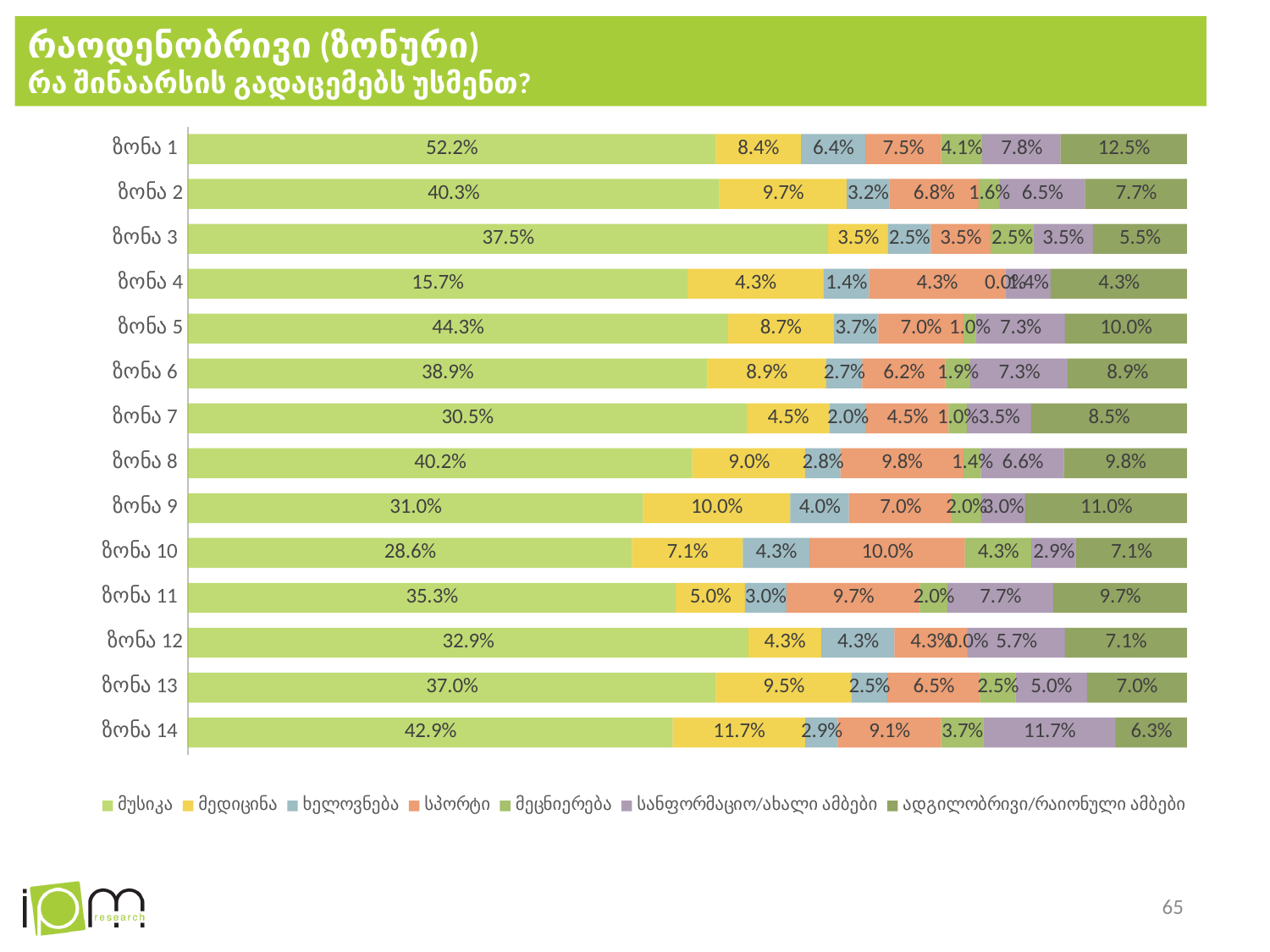
What type of chart is shown on the slide? stacked bar chart Which series is shown first (leftmost) in the legend? მუსიკა Which zone has the highest value for მუსიკა? ზონა 1 What is the value for მედიცინა in ზონა 14? 11.7% How many zones (categories) are shown on the chart? 14 What is the difference between the მუსიკა values for ზონა 1 and ზონა 2? 11.9% Which zone has the lowest value for მუსიკა? ზონა 4 What is the value for სპორტი in ზონა 10? 10.0% What is the value for მუსიკა in ზონა 1? 52.2% What is the value for ადგილობრივი/რაიონული ამბები in ზონა 9? 11.0% How many series does the legend list? 7 Which is larger: the მედიცინა value for ზონა 9 or for ზონა 8? ზონა 9